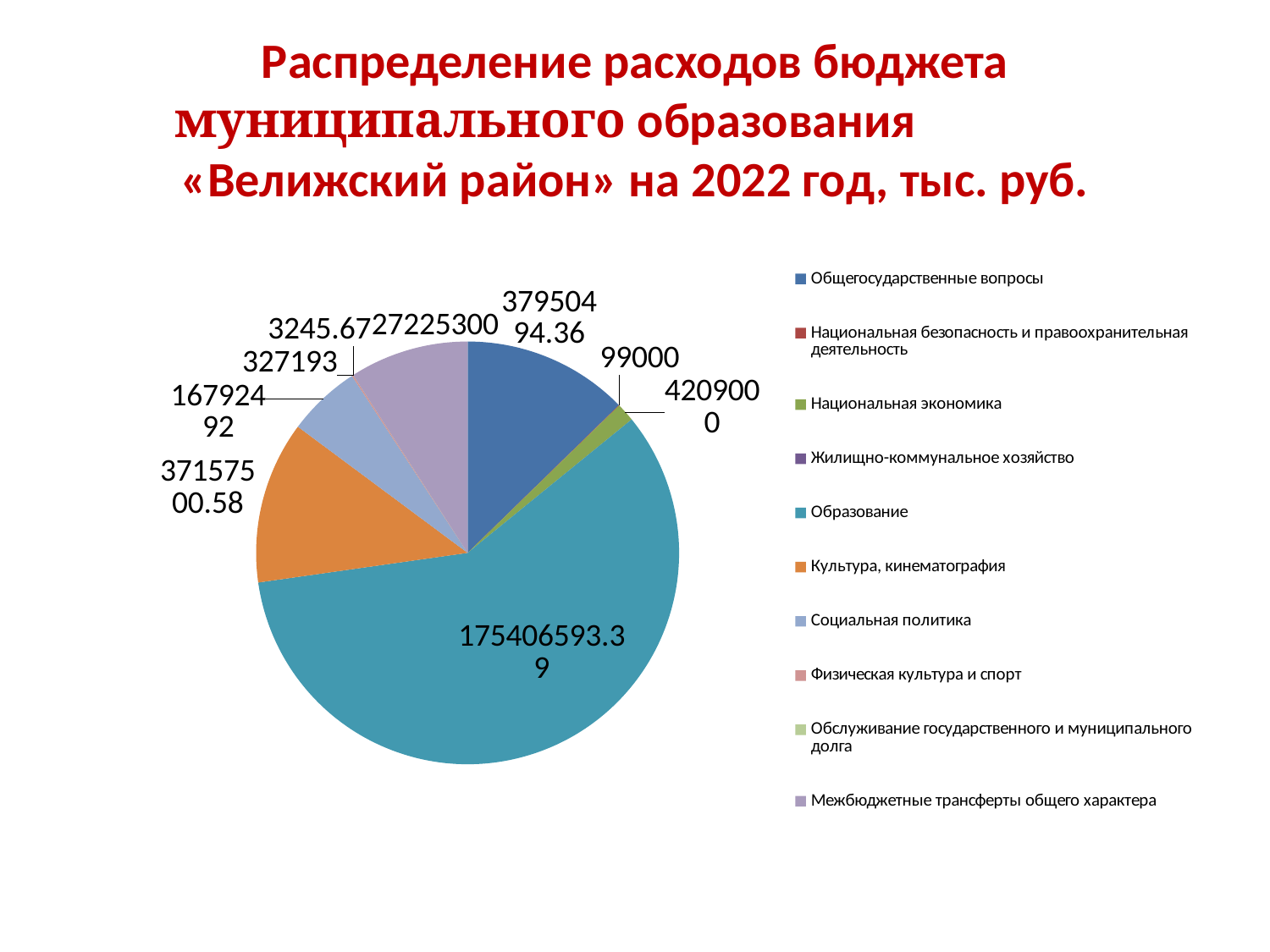
What kind of chart is shown on the slide? pie chart What is the value shown for Культура, кинематография? 37157500.58 Which category has the largest slice of the pie chart? Образование Which is larger, the value for Образование or the value for Культура, кинематография? Образование What is the value shown for Общегосударственные вопросы? 37950494.36 What is the value shown for Межбюджетные трансферты общего характера? 27225300 How many categories does the legend of the pie chart list? 10 What is the value shown for Образование? 175406593.39 What is the value shown for Социальная политика? 16792492 What year does the chart title say the budget expenditure distribution is for? 2022 Which is larger, the value for Общегосударственные вопросы or the value for Социальная политика? Общегосударственные вопросы What is the difference between the values for Образование and Культура, кинематография? 138249092.81